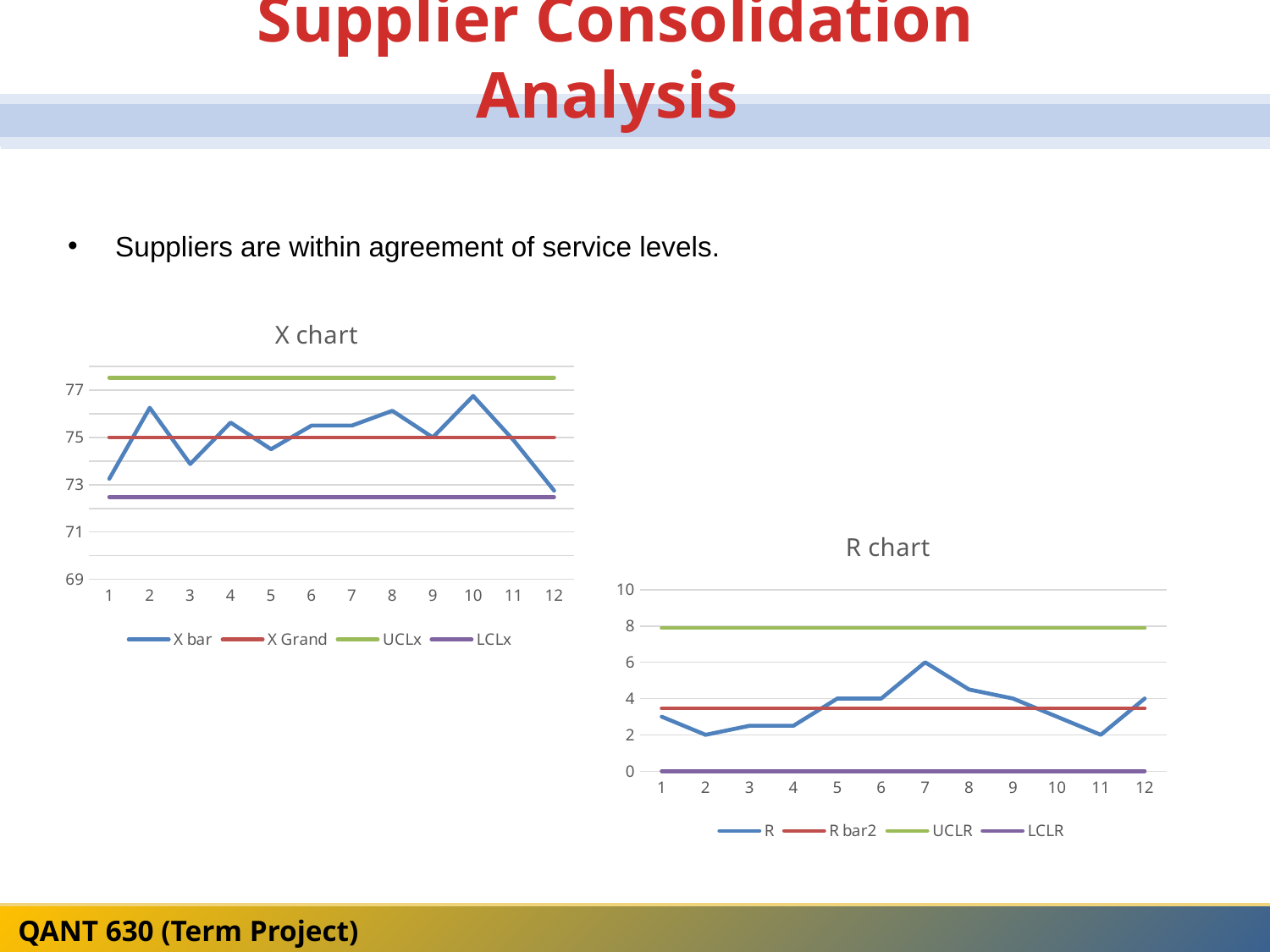
In the X chart, is the X bar value at point 3 greater or less than 75? less How many points are plotted along the x axis of the R chart? 12 What kind of chart is the X chart? line chart In the R chart, is the UCLR line greater or less than 6? greater In the R chart, does the R series rise or fall from point 7 to point 11? fall How many series does the legend of the X chart list? 4 In the R chart, is the R value at point 7 greater or less than 4? greater In the R chart, which is larger: the R value at point 7 or the R value at point 1? point 7 How many series does the legend of the R chart list? 4 In the R chart, at which x-axis point is the R series highest? 7 In the X chart, at which x-axis point is the X bar series highest? 10 In the X chart, at which x-axis point is the X bar series lowest? 12